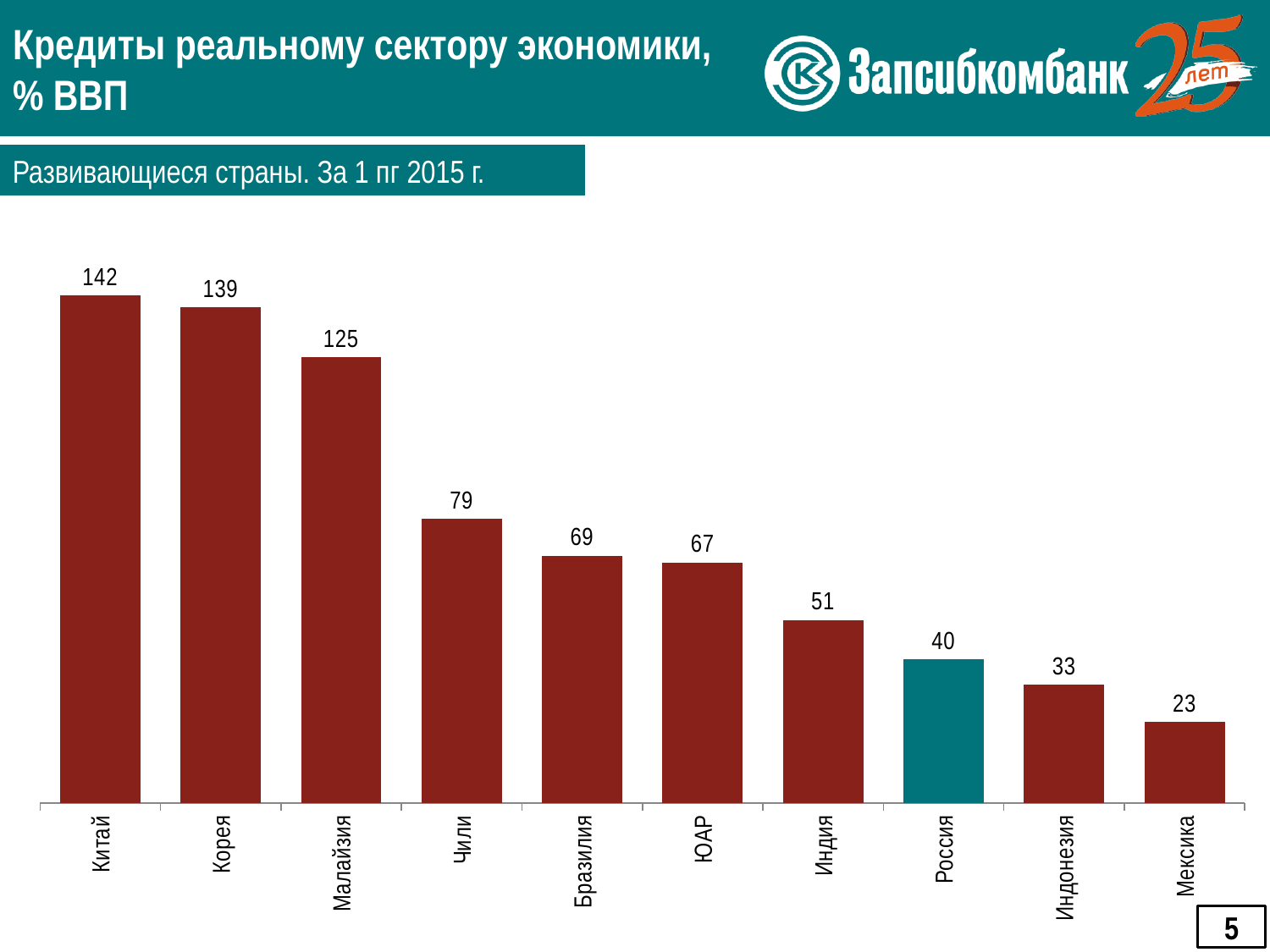
How many countries are shown in the chart? 10 What is the value for Бразилия? 69 What is the difference between the values for Китай and Россия? 102 Which country has the lowest value? Мексика Which is larger, the value for Чили or the value for Индия? Чили What is the value for Китай? 142 Which country has the highest value? Китай Which country's bar is shown in a different colour (teal) from the others? Россия What is the value for Россия? 40 What kind of chart is shown on the slide? bar chart What is the difference between the values for Корея and Малайзия? 14 Do the values rise or fall from left to right along the x axis? fall